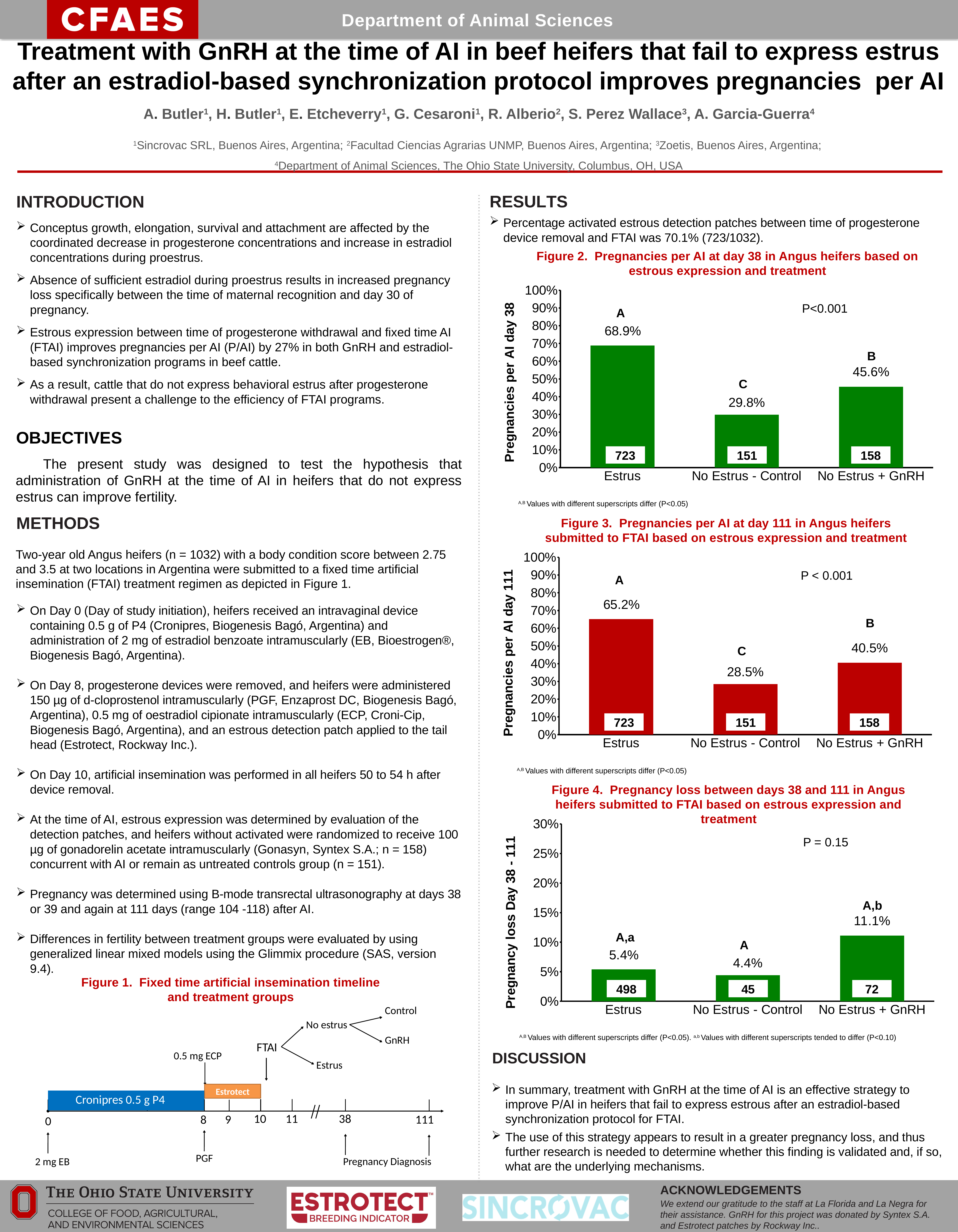
In Figure 3 (Pregnancies per AI at day 111), what is the value for No Estrus + GnRH? 40.5% In Figure 4 (Pregnancy loss between days 38 and 111), which is larger, the value for Estrus or for No Estrus - Control? Estrus What kind of chart is Figure 3 (Pregnancies per AI at day 111)? Bar chart In Figure 4 (Pregnancy loss between days 38 and 111), what is the value for the Estrus group? 5.4% How many categories are plotted in Figure 2 (Pregnancies per AI at day 38)? 3 In Figure 2 (Pregnancies per AI at day 38), which category has the lowest pregnancies per AI? No Estrus - Control In Figure 4 (Pregnancy loss between days 38 and 111), which category has the highest pregnancy loss? No Estrus + GnRH In Figure 2 (Pregnancies per AI at day 38), what is the value for the Estrus group? 68.9% In Figure 3 (Pregnancies per AI at day 111), is the value for No Estrus - Control greater or less than 30%? less In Figure 2 (Pregnancies per AI at day 38), what is the difference between the Estrus and No Estrus + GnRH values? 23.3% In Figure 3 (Pregnancies per AI at day 111), which category has the highest pregnancies per AI? Estrus In Figure 4 (Pregnancy loss between days 38 and 111), what is the difference between the No Estrus + GnRH and No Estrus - Control values? 6.7%